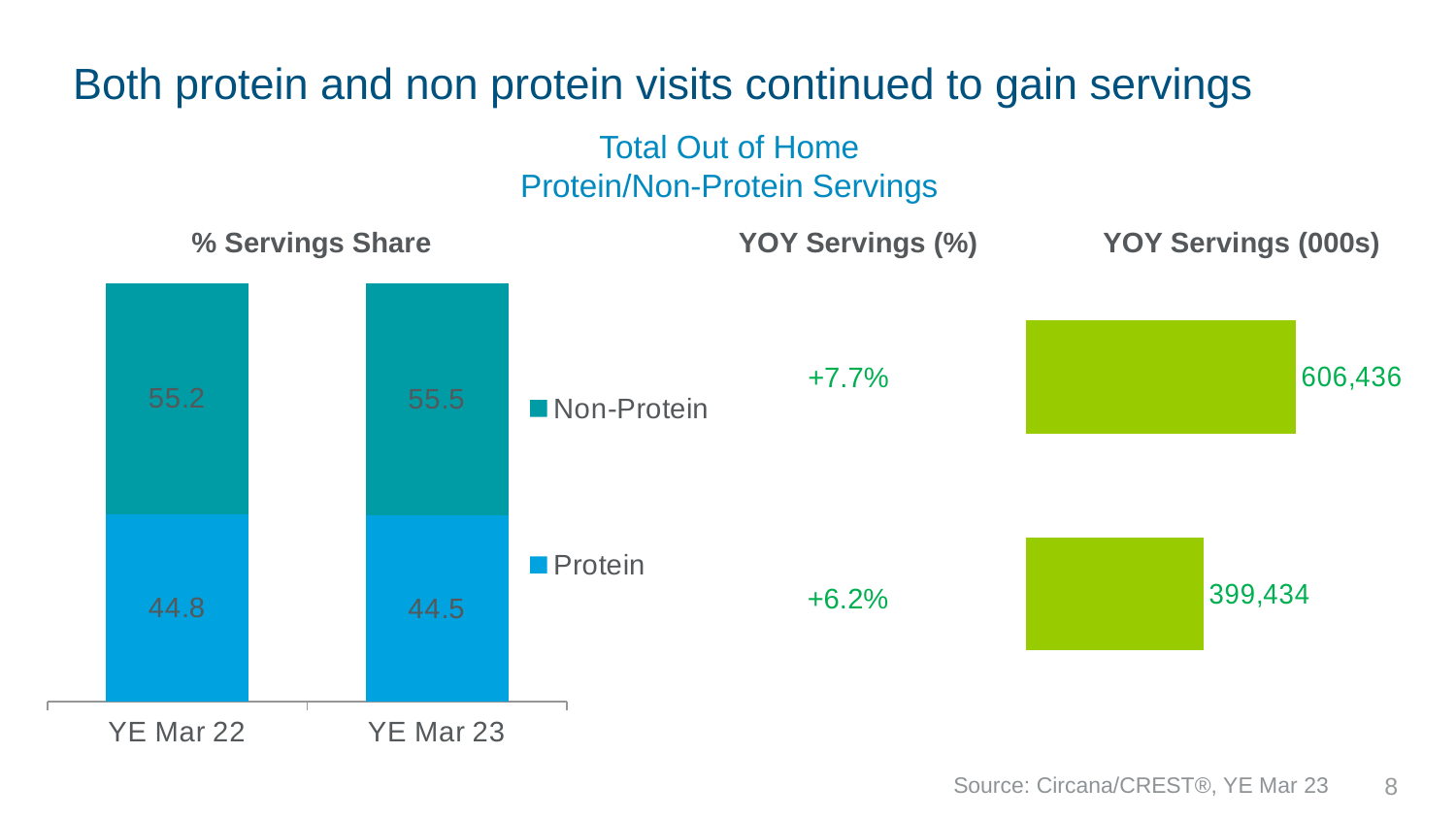
What kind of chart is the % Servings Share chart? Stacked bar chart In the % Servings Share chart, what is the difference between the Non-Protein and Protein values for YE Mar 23? 11.0 In the YOY Servings (%) column, what is the value for Protein? +6.2% In the % Servings Share chart, what is the Protein value for YE Mar 22? 44.8 In the % Servings Share chart, what is the Non-Protein value for YE Mar 23? 55.5 In the YOY Servings (000s) chart, which category has the lower value? Protein In the % Servings Share chart, how many categories are shown on the x axis? 2 In the % Servings Share chart, what is the Protein value for YE Mar 23? 44.5 In the % Servings Share chart, how many series does the legend list? 2 In the % Servings Share chart, what is the total of the stacked bar for YE Mar 22? 100 In the % Servings Share chart, does the Protein share rise or fall from YE Mar 22 to YE Mar 23? Fall In the YOY Servings (000s) chart, what is the value for Non-Protein? 606,436